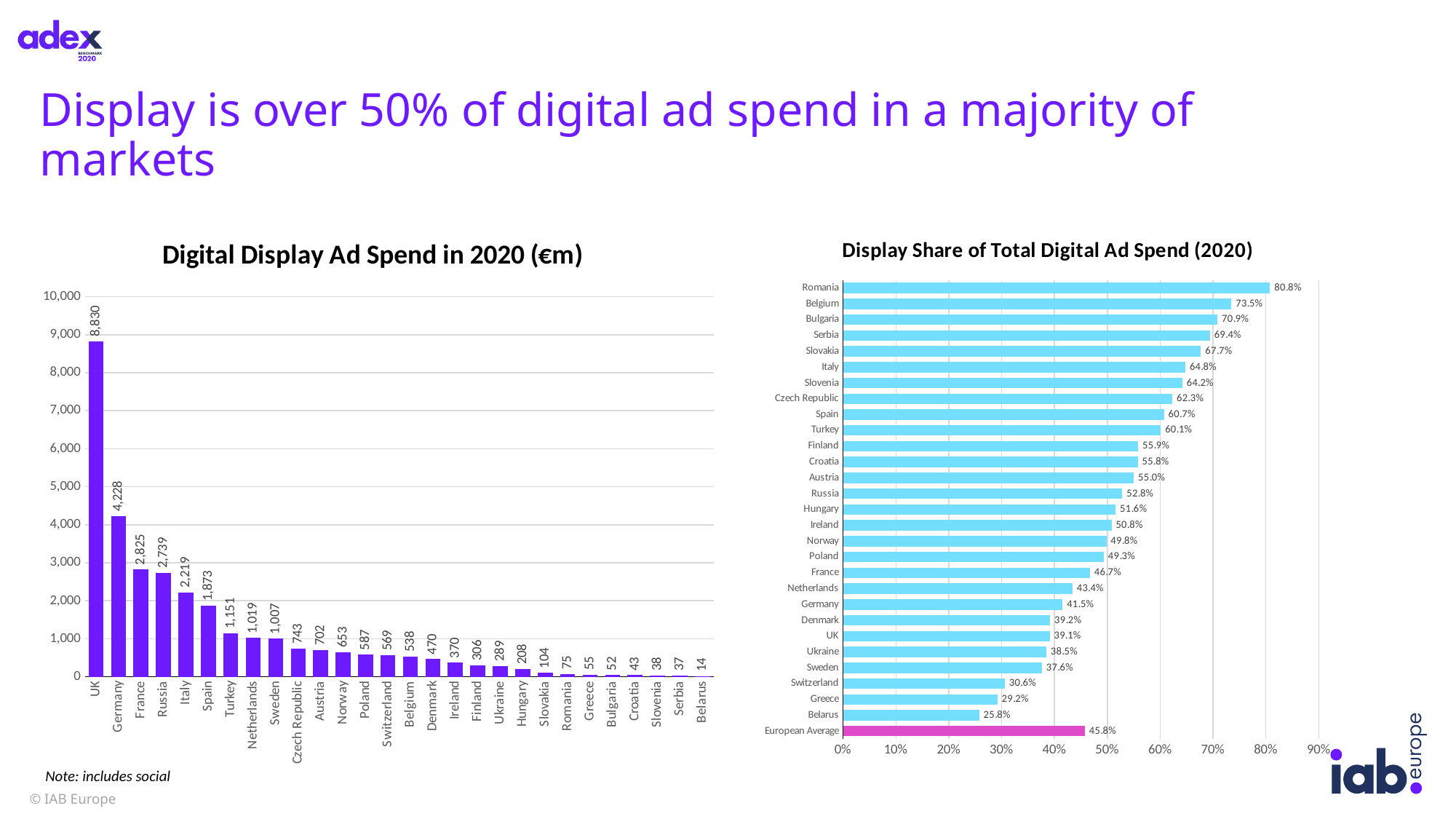
In the 'Display Share of Total Digital Ad Spend (2020)' chart, what is the value for European Average? 45.8% In the 'Digital Display Ad Spend in 2020 (€m)' chart, how many countries are shown? 28 In the 'Display Share of Total Digital Ad Spend (2020)' chart, what is the difference between the values for Belgium and Bulgaria? 2.6% In the 'Display Share of Total Digital Ad Spend (2020)' chart, what is the value for Romania? 80.8% In the 'Digital Display Ad Spend in 2020 (€m)' chart, what is the value for Germany? 4,228 In the 'Display Share of Total Digital Ad Spend (2020)' chart, which is larger, the value for Germany or the value for Netherlands? Netherlands In the 'Digital Display Ad Spend in 2020 (€m)' chart, what is the difference between the values for France and Russia? 86 What kind of chart is the 'Display Share of Total Digital Ad Spend (2020)' chart? bar chart In the 'Digital Display Ad Spend in 2020 (€m)' chart, which country has the lowest value? Belarus In the 'Digital Display Ad Spend in 2020 (€m)' chart, do the values rise or fall from left to right? fall In the 'Display Share of Total Digital Ad Spend (2020)' chart, which country has the lowest share? Belarus In the 'Digital Display Ad Spend in 2020 (€m)' chart, which country has the highest value? UK